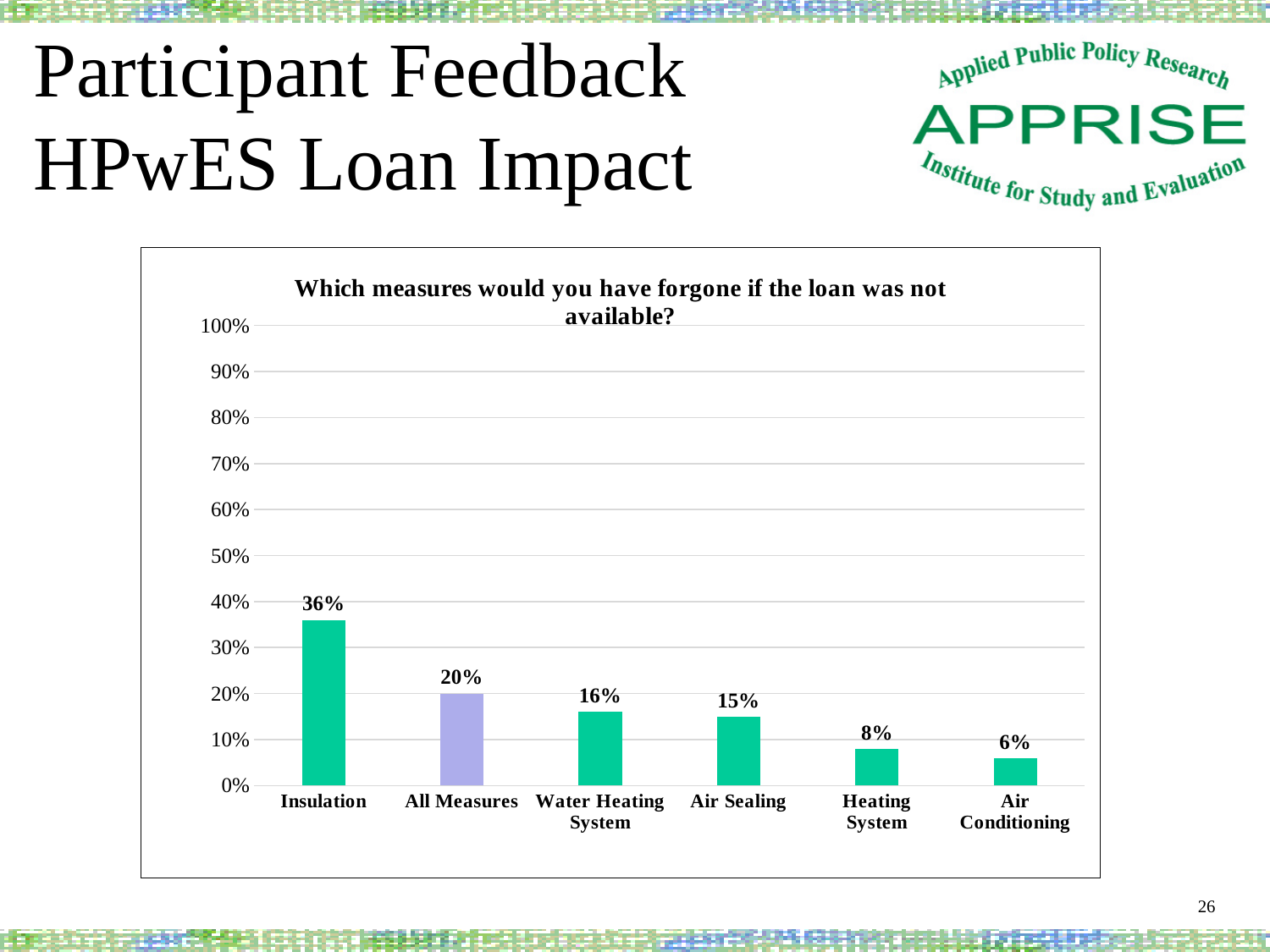
Which is larger, the value for Water Heating System or the value for Heating System? Water Heating System What is the difference between the values for Water Heating System and Air Conditioning? 10% How many measure categories are shown on the x axis? 6 What is the title of the chart? Which measures would you have forgone if the loan was not available? What is the value shown for Heating System? 8% Which measure has the highest percentage in the chart? Insulation What percentage of participants said they would have forgone Insulation if the loan was not available? 36% Is the value for Air Sealing greater or less than 20%? less What is the value shown for All Measures? 20% Which measure has the lowest percentage in the chart? Air Conditioning What kind of chart is shown on the slide? Bar chart What is the difference between the values for Insulation and All Measures? 16%